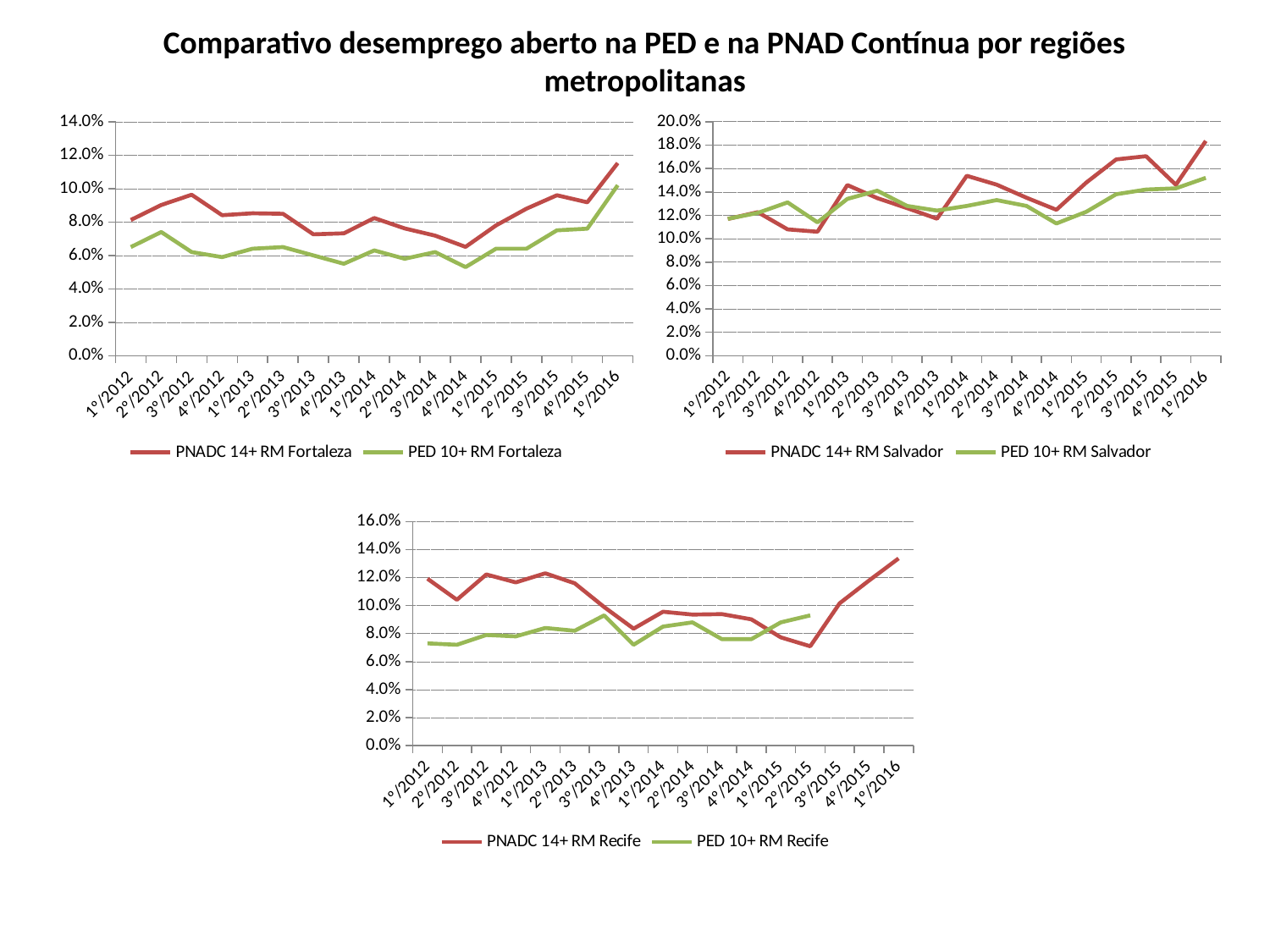
In the Fortaleza chart (top left), does PNADC 14+ RM Fortaleza rise or fall from 4°/2014 to 1°/2016? rise What colour is the line for PED 10+ RM Salvador in the Salvador chart (top right)? green What kind of chart is the Fortaleza chart (top left)? line chart In the Recife chart (bottom), which series has the larger value at 1°/2012, PNADC 14+ RM Recife or PED 10+ RM Recife? PNADC 14+ RM Recife In the Salvador chart (top right), at which quarter does PNADC 14+ RM Salvador reach its highest value? 1°/2016 In the Fortaleza chart (top left), at which quarter does PNADC 14+ RM Fortaleza reach its highest value? 1°/2016 In the Fortaleza chart (top left), is the value for PED 10+ RM Fortaleza at 4°/2014 greater or less than 6.0%? less In the Recife chart (bottom), at which quarter does PNADC 14+ RM Recife reach its lowest value? 2°/2015 How many series does the legend of the Salvador chart (top right) list? 2 How many quarters are shown on the x axis of the Recife chart (bottom)? 17 In the Salvador chart (top right), is the value for PNADC 14+ RM Salvador at 1°/2016 greater or less than 16.0%? greater In the Fortaleza chart (top left), is the value for PNADC 14+ RM Fortaleza at 1°/2016 greater or less than 10.0%? greater